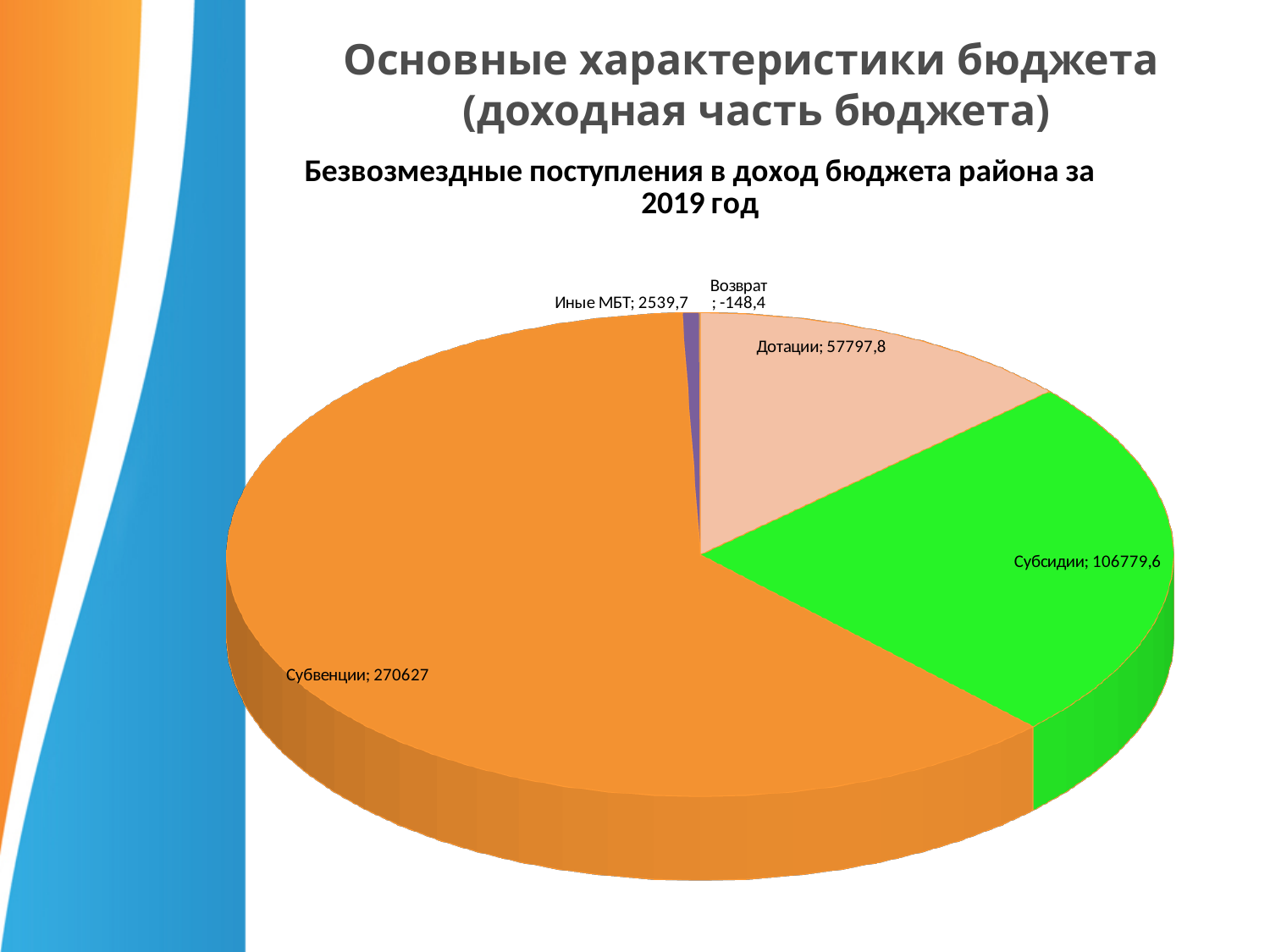
How many categories are shown in the pie chart? 5 What is the value for Иные МБТ? 2539,7 What is the value for Субсидии? 106779,6 Which is larger, the value for Субсидии or the value for Дотации? Субсидии What is the title of the chart? Безвозмездные поступления в доход бюджета района за 2019 год What is the value for Дотации? 57797,8 Which category has the largest value? Субвенции What is the difference between the values for Субвенции and Субсидии? 163847,4 What kind of chart is shown on the slide? Pie chart What is the value for Возврат? -148,4 Which category has the smallest value? Возврат What is the value for Субвенции? 270627